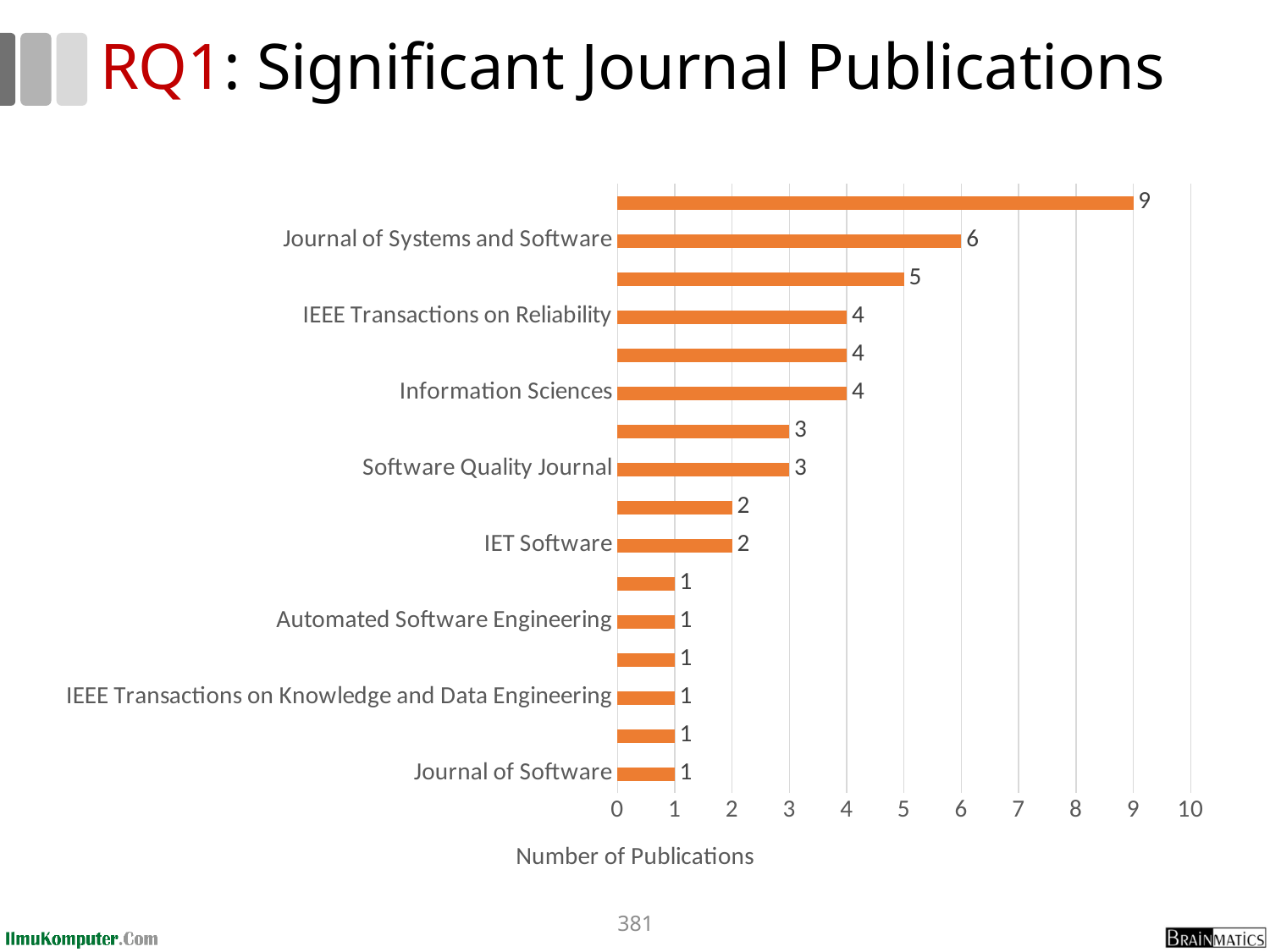
How many publications are shown for Journal of Software? 1 Which has more publications, Journal of Systems and Software or Software Quality Journal? Journal of Systems and Software What is the difference between the values for Journal of Systems and Software and Information Sciences? 2 What is the value for IEEE Transactions on Reliability? 4 What is the largest value shown by any bar in the chart? 9 How many bars are plotted in the chart? 16 What is the number of publications for Software Quality Journal? 3 Which has a higher value, IET Software or Automated Software Engineering? IET Software How many publications does the chart show for Journal of Systems and Software? 6 What is the value shown for IET Software? 2 What type of chart is shown on the slide? Bar chart What is the title of the horizontal axis? Number of Publications